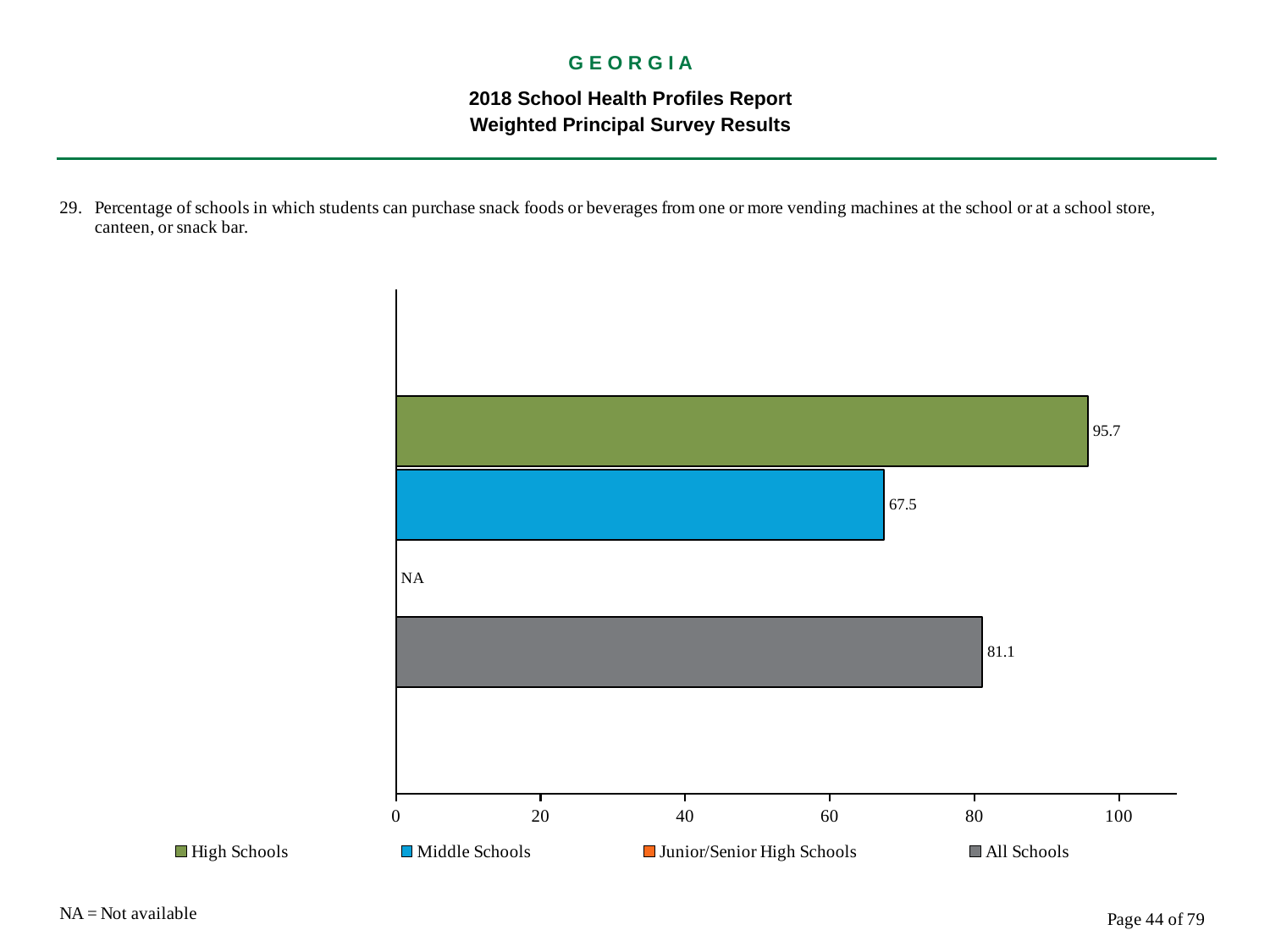
Which is larger, the value for All Schools or the value for Middle Schools? All Schools What is the value for All Schools? 81.1 What is the value for Middle Schools? 67.5 Which school type has the highest value? High Schools What is the value for High Schools? 95.7 Is the value for Middle Schools greater or less than 80? less What kind of chart is shown on the slide? bar chart What is shown for Junior/Senior High Schools? NA How many series does the legend list? 4 What is the difference between the High Schools and Middle Schools values? 28.2 What is the difference between the All Schools and Middle Schools values? 13.6 Among the school types with a plotted value, which has the lowest? Middle Schools